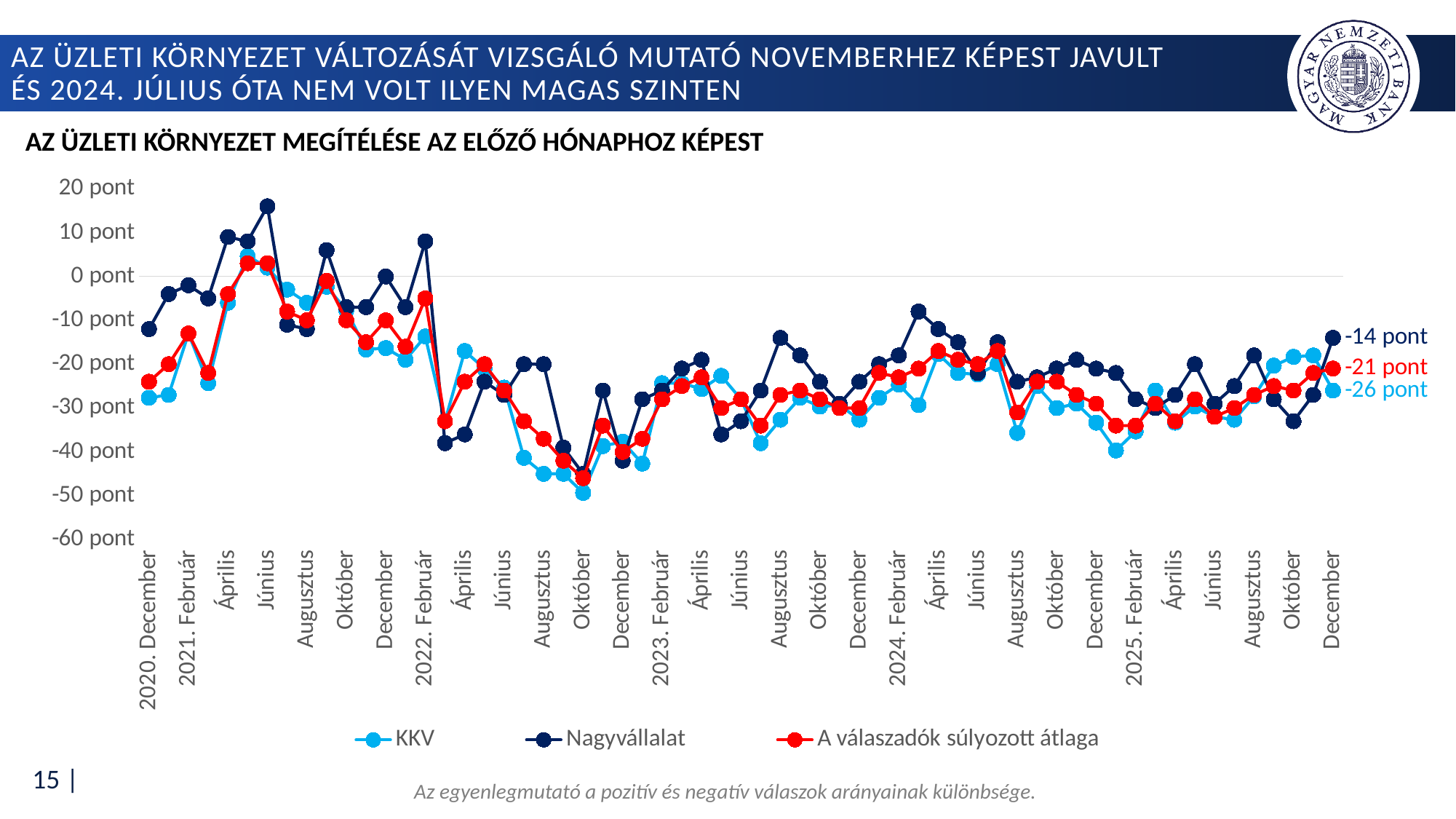
What is the value for Nagyvállalat in 2025 December? -14 pont In 2025 December, which is larger, the KKV value or the Nagyvállalat value? Nagyvállalat What is the value for KKV in 2025 December? -26 pont Is the value for Nagyvállalat in 2021 Június greater or less than 10 pont? greater Which series has the highest value in 2025 December? Nagyvállalat What is the difference between the Nagyvállalat and KKV values in 2025 December? 12 pont What is the difference between the Nagyvállalat value and A válaszadók súlyozott átlaga in 2025 December? 7 pont What is the value for A válaszadók súlyozott átlaga in 2025 December? -21 pont Is the value for KKV in 2022 Október greater or less than -40 pont? less Which series has the lowest value in 2025 December? KKV How many series does the legend list? 3 What kind of chart is shown on the slide? Line chart